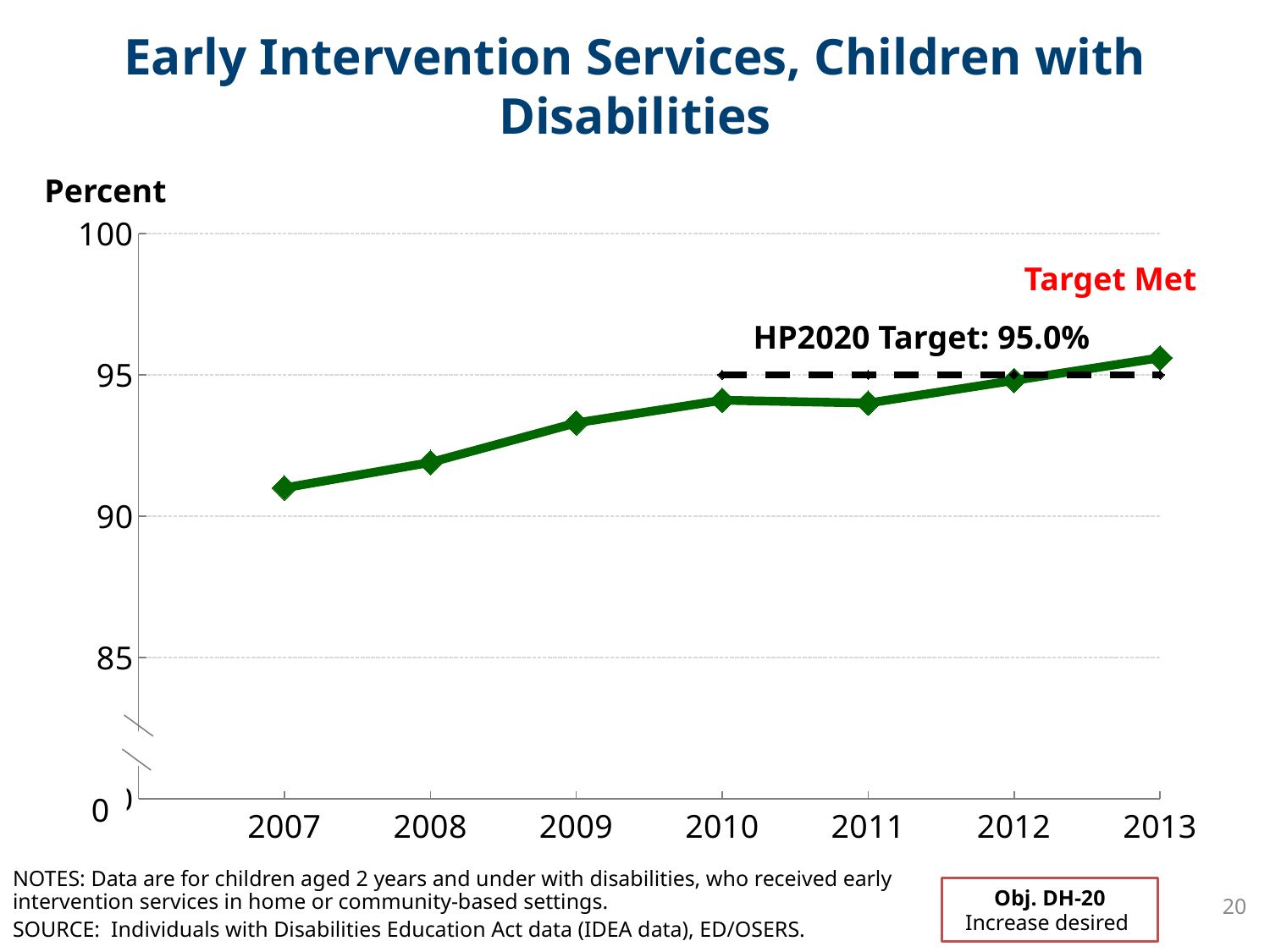
What is the label on the y axis? Percent Is the value for 2008 greater or less than 90? greater Which year has the lowest value? 2007 Which year has the highest value? 2013 Which year has the larger value, 2009 or 2008? 2009 Do the values generally rise or fall from 2007 to 2013? rise Is the value for 2007 greater or less than 95? less How many years are plotted on the x axis? 7 Is the value for 2010 greater or less than 95? less What is the HP2020 target value shown on the chart? 95.0% What kind of chart is shown on the slide? line chart